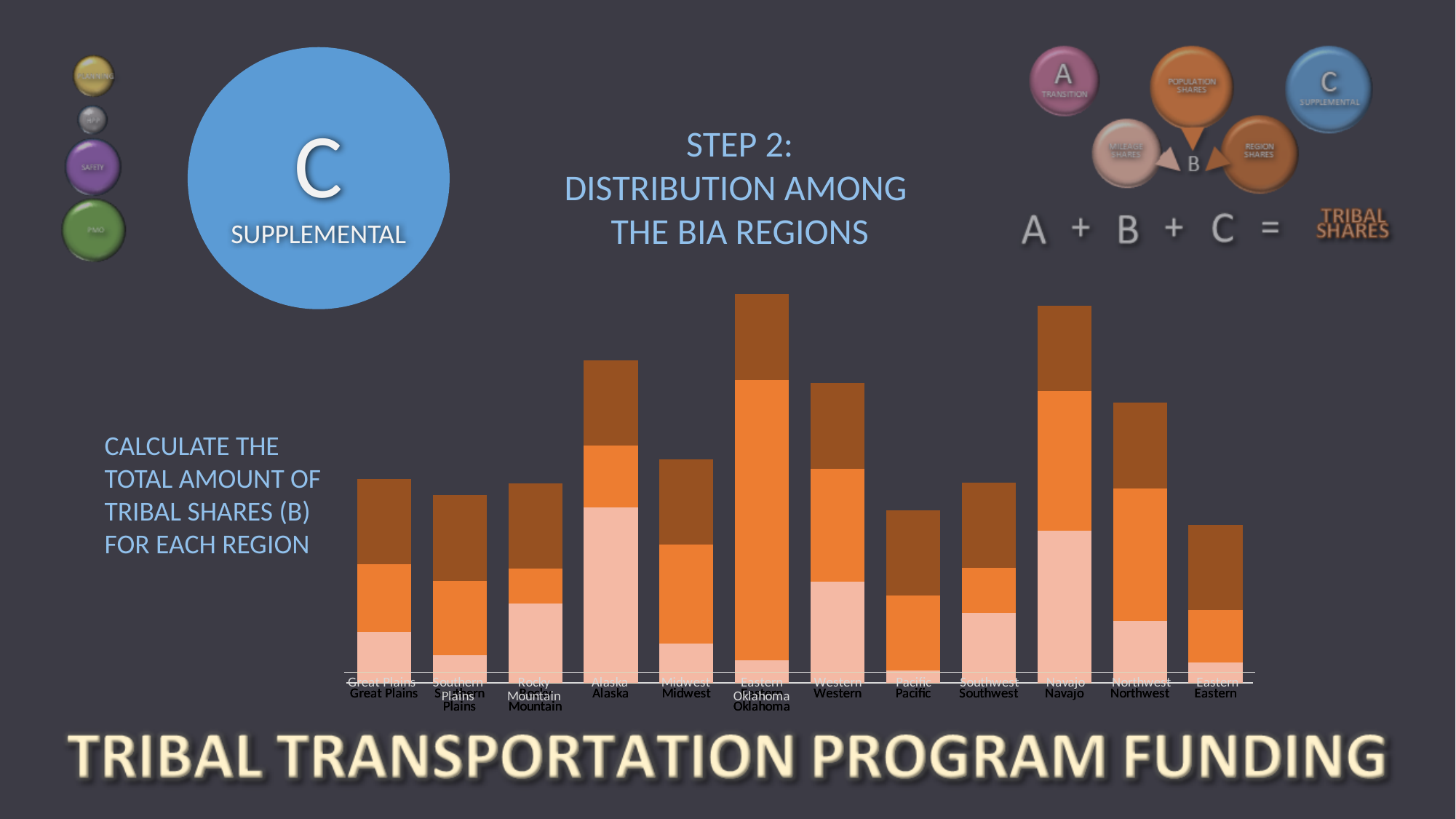
Which region has the tallest stacked bar in the chart? Eastern Oklahoma Which bar is taller in the chart, Navajo or Alaska? Navajo Which bar is taller in the chart, Midwest or Southwest? Midwest How many stacked segments make up each bar in the chart? 3 Which bar is taller in the chart, Alaska or Western? Alaska How many regions (categories) are shown along the x axis of the chart? 12 Which region has the largest bottom (lightest-coloured) segment in its stacked bar? Alaska Which region's bar is the first (leftmost) category on the x axis? Great Plains Which region's bar is the last (rightmost) category on the x axis? Eastern What kind of chart is shown on the slide? stacked bar chart